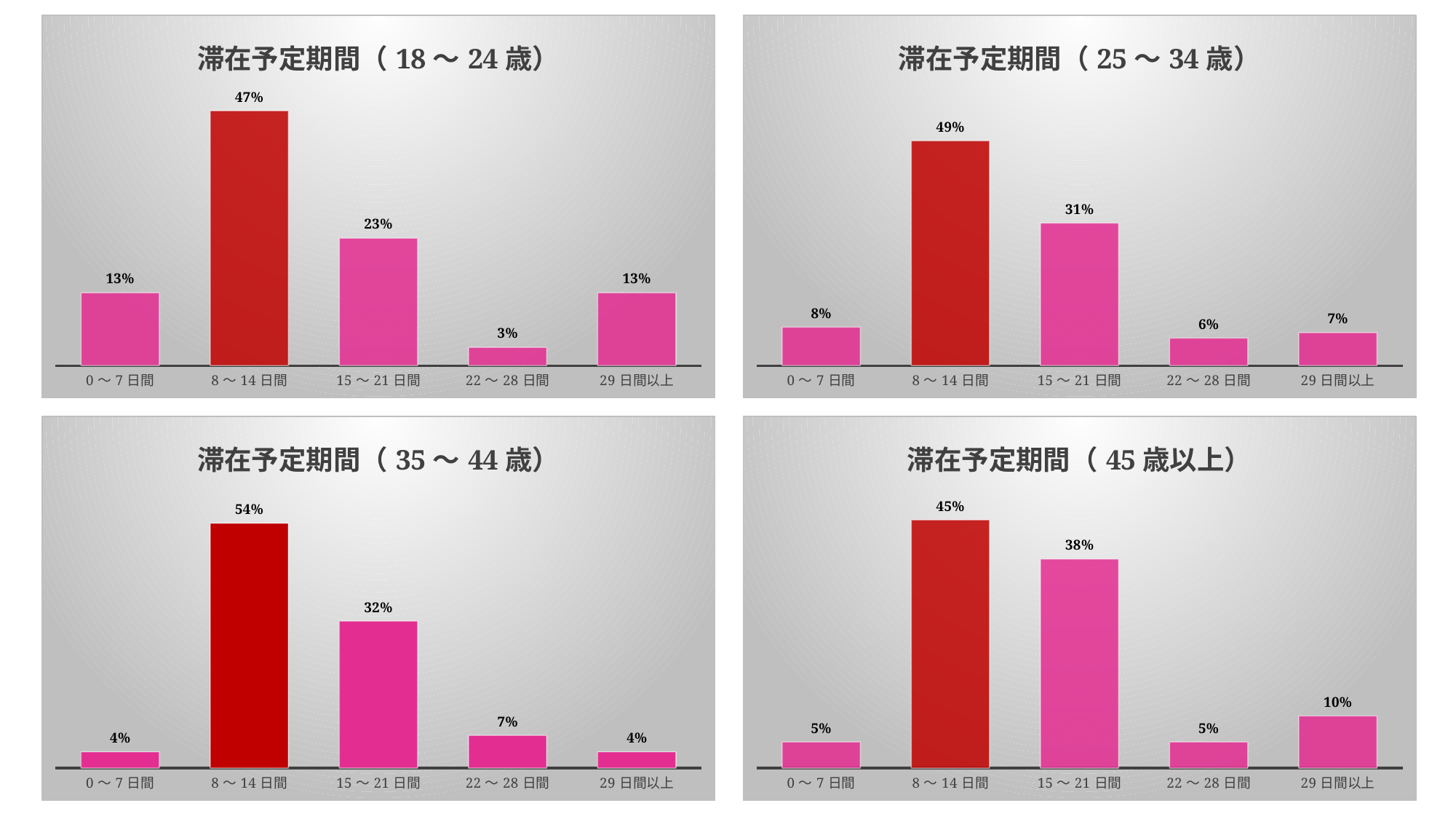
In the chart titled 滞在予定期間（45歳以上）, which is larger, the value for 29日間以上 or the value for 0～7日間? 29日間以上 In the chart titled 滞在予定期間（25～34歳）, what is the value for 15～21日間? 31% In the chart titled 滞在予定期間（25～34歳）, what is the value for 0～7日間? 8% What kind of chart is the chart titled 滞在予定期間（18～24歳）? Bar chart In the chart titled 滞在予定期間（35～44歳）, which category has the highest value? 8～14日間 In the chart titled 滞在予定期間（35～44歳）, what is the value for 22～28日間? 7% How many charts are shown on the slide? 4 How many categories are shown in the chart titled 滞在予定期間（25～34歳）? 5 In the chart titled 滞在予定期間（45歳以上）, which category has the lowest value? 0～7日間 and 22～28日間 (both 5%) In the chart titled 滞在予定期間（18～24歳）, what is the difference between the values for 8～14日間 and 15～21日間? 24% In the chart titled 滞在予定期間（35～44歳）, what is the difference between the values for 8～14日間 and 15～21日間? 22% In the chart titled 滞在予定期間（18～24歳）, what is the value for 8～14日間? 47%